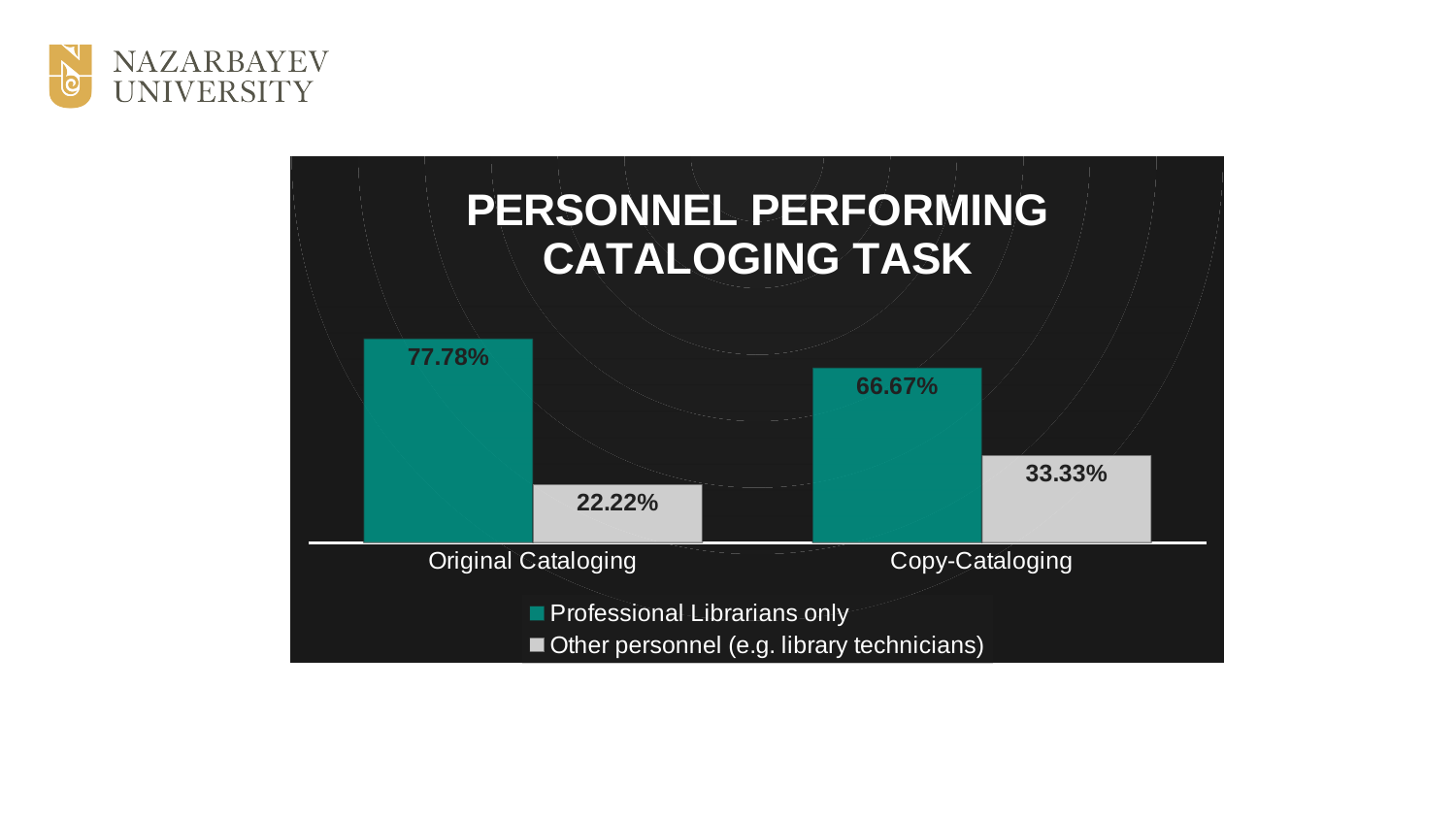
How many categories are shown on the x axis? 2 Which is larger: Other personnel in Copy-Cataloging or Other personnel in Original Cataloging? Other personnel in Copy-Cataloging What is the value for Other personnel (e.g. library technicians) in Copy-Cataloging? 33.33% What is the value for Other personnel (e.g. library technicians) in Original Cataloging? 22.22% What is the difference between Professional Librarians only and Other personnel in Copy-Cataloging? 33.34% Which category has the highest value for Professional Librarians only? Original Cataloging Which category has the lowest value for Other personnel (e.g. library technicians)? Original Cataloging How many series does the legend list? 2 What is the value for Professional Librarians only in Copy-Cataloging? 66.67% What kind of chart is shown on the slide? Bar chart What is the difference between Professional Librarians only and Other personnel in Original Cataloging? 55.56% What is the value for Professional Librarians only in Original Cataloging? 77.78%